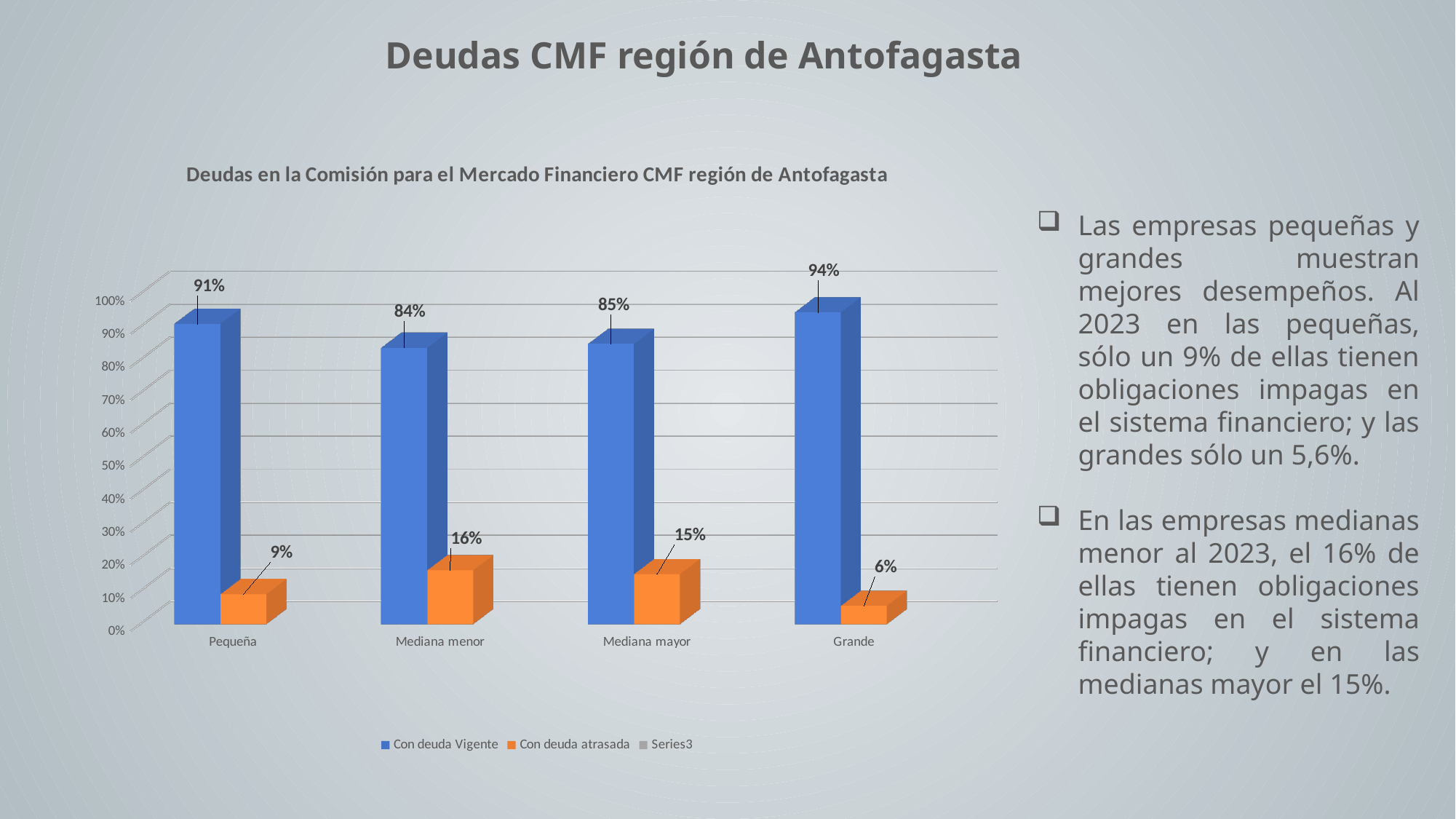
Which category has the lowest value in the Con deuda atrasada series? Grande What is the title of the chart? Deudas en la Comisión para el Mercado Financiero CMF región de Antofagasta Which category has the highest value in the Con deuda Vigente series? Grande What is the value for Pequeña in the Con deuda Vigente series? 91% What is the value for Mediana mayor in the Con deuda atrasada series? 15% What is the difference between the Con deuda Vigente values for Grande and Mediana menor? 10% What is the value for Mediana menor in the Con deuda atrasada series? 16% How many categories are shown on the x axis? 4 What kind of chart is shown on the slide? Bar chart What is the value for Grande in the Con deuda Vigente series? 94% Which is larger: the Con deuda atrasada value for Pequeña or for Mediana menor? Mediana menor How many series does the legend list? 3